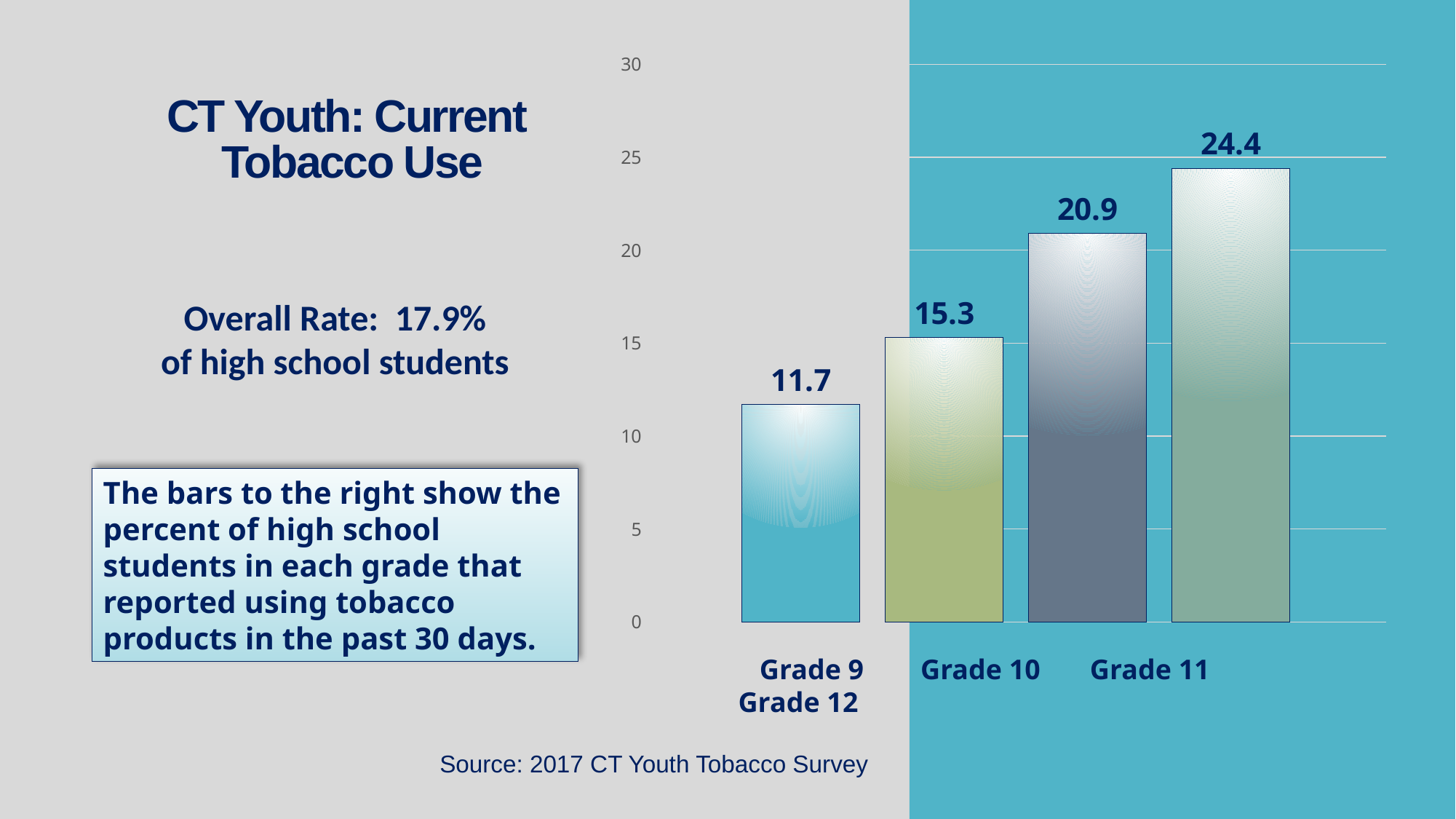
How many bars are plotted in the chart? 4 Which bar has the lowest value? Grade 9 What is the value shown on the rightmost (fourth) bar? 24.4 What kind of chart is shown on the slide? Bar chart Do the bar values rise or fall from left to right across the chart? Rise What is the value shown for Grade 9? 11.7 What is the value shown for Grade 11? 20.9 What is the difference between the values for Grade 11 and Grade 9? 9.2 What is the difference between the values for Grade 10 and Grade 9? 3.6 What is the value shown for Grade 10? 15.3 What is the highest value shown on any bar in the chart? 24.4 Which is larger, the value for Grade 10 or the value for Grade 11? Grade 11